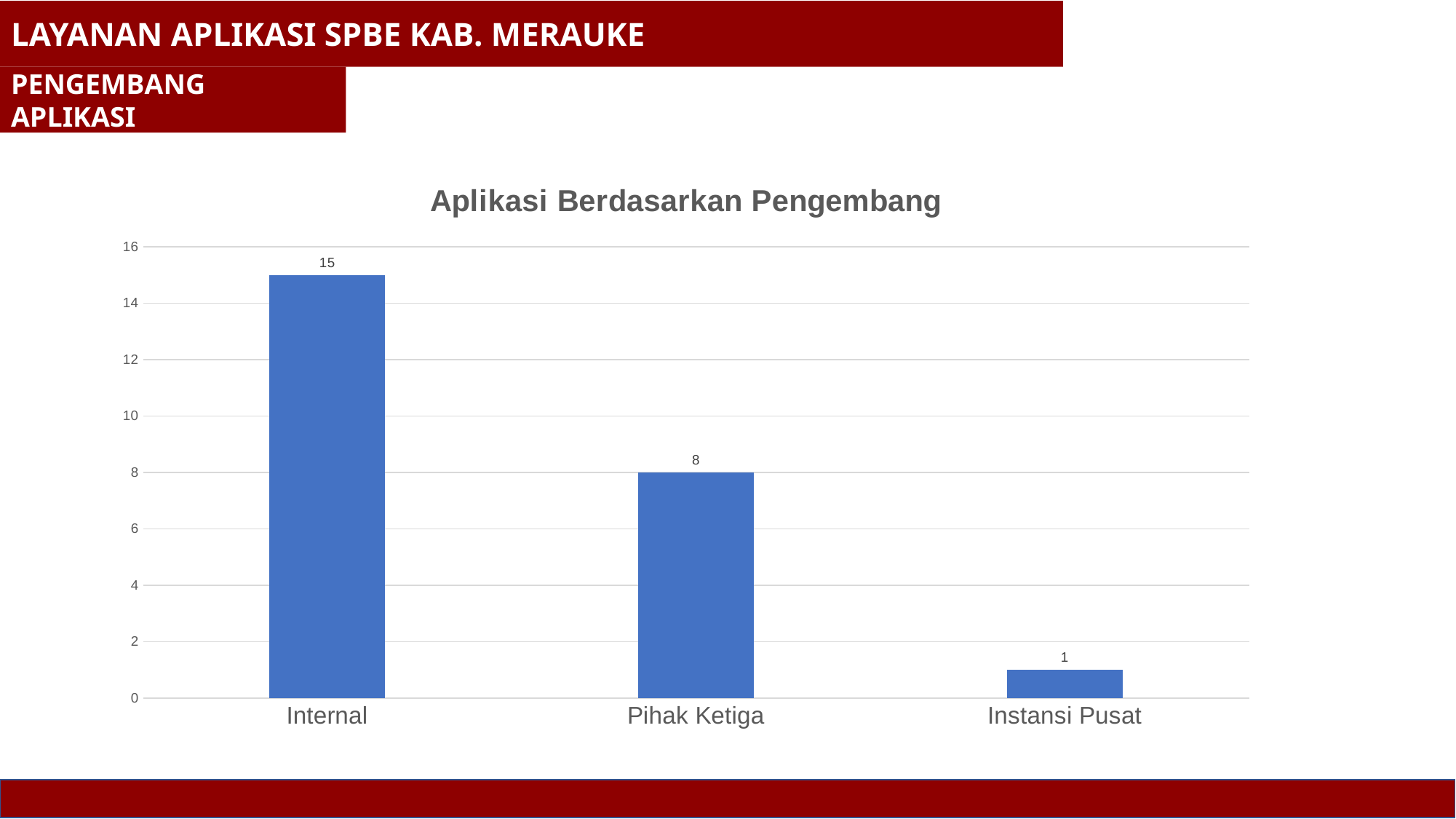
Which is larger, the value for Pihak Ketiga or the value for Instansi Pusat? Pihak Ketiga What is the value for Instansi Pusat? 1 What is the title of the chart? Aplikasi Berdasarkan Pengembang What is the value for Pihak Ketiga? 8 What is the value for Internal? 15 Which category has the lowest value? Instansi Pusat What kind of chart is shown on the slide? bar chart What is the difference between the values for Internal and Pihak Ketiga? 7 Is the value for Internal greater or less than 10? greater What is the difference between the values for Pihak Ketiga and Instansi Pusat? 7 How many categories are shown on the x axis? 3 Which category has the highest value? Internal